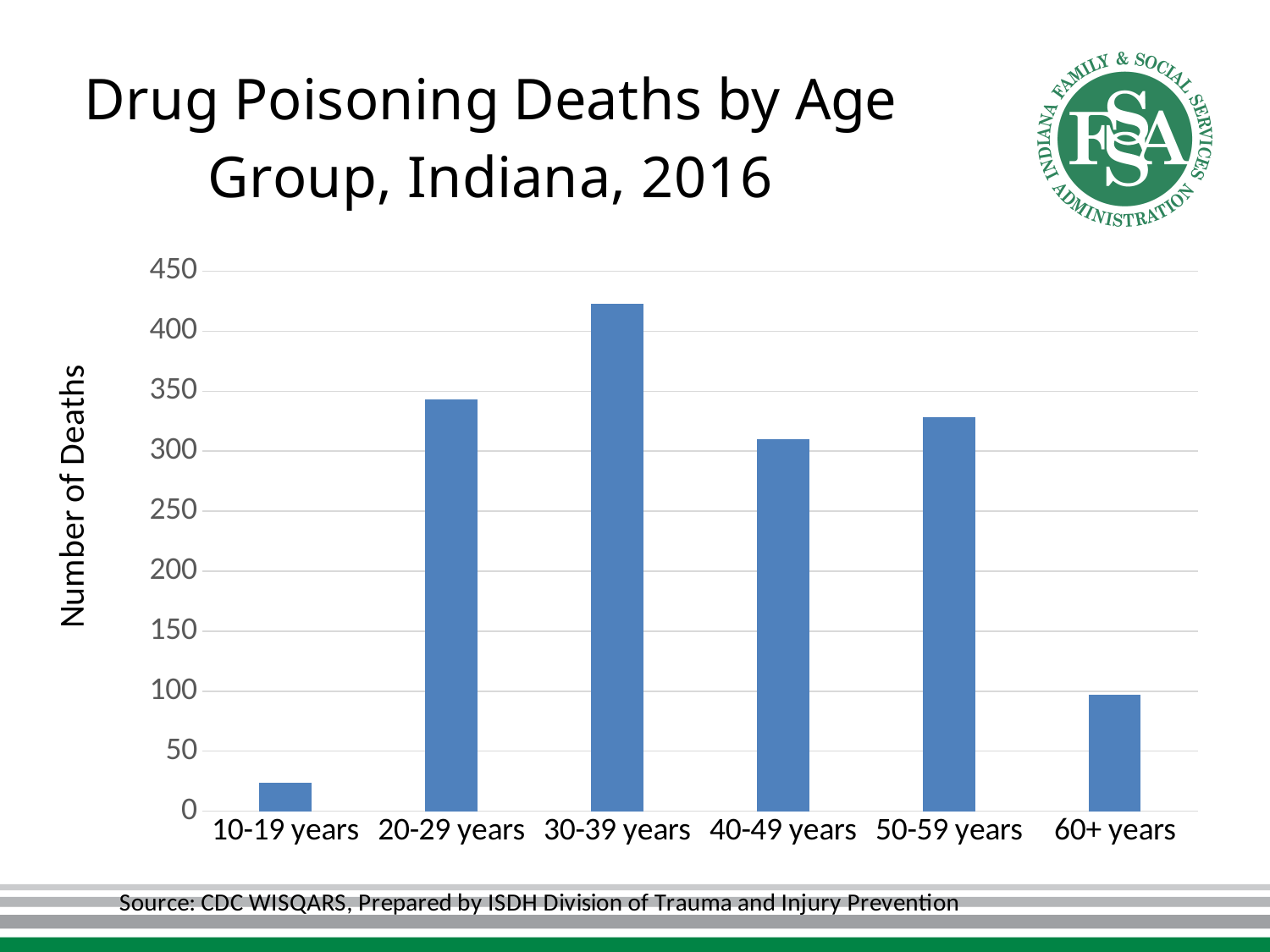
Which has more deaths, 20-29 years or 40-49 years? 20-29 years Which has more deaths, 60+ years or 10-19 years? 60+ years Is the value for 30-39 years greater or less than 400? greater What is the label on the y axis of the chart? Number of Deaths Is the value for 40-49 years greater or less than 350? less Which age group has the lowest number of drug poisoning deaths? 10-19 years Is the value for 20-29 years greater or less than 300? greater How many age groups are shown on the x axis? 6 What type of chart is shown on the slide? bar chart Which age group has the highest number of drug poisoning deaths? 30-39 years